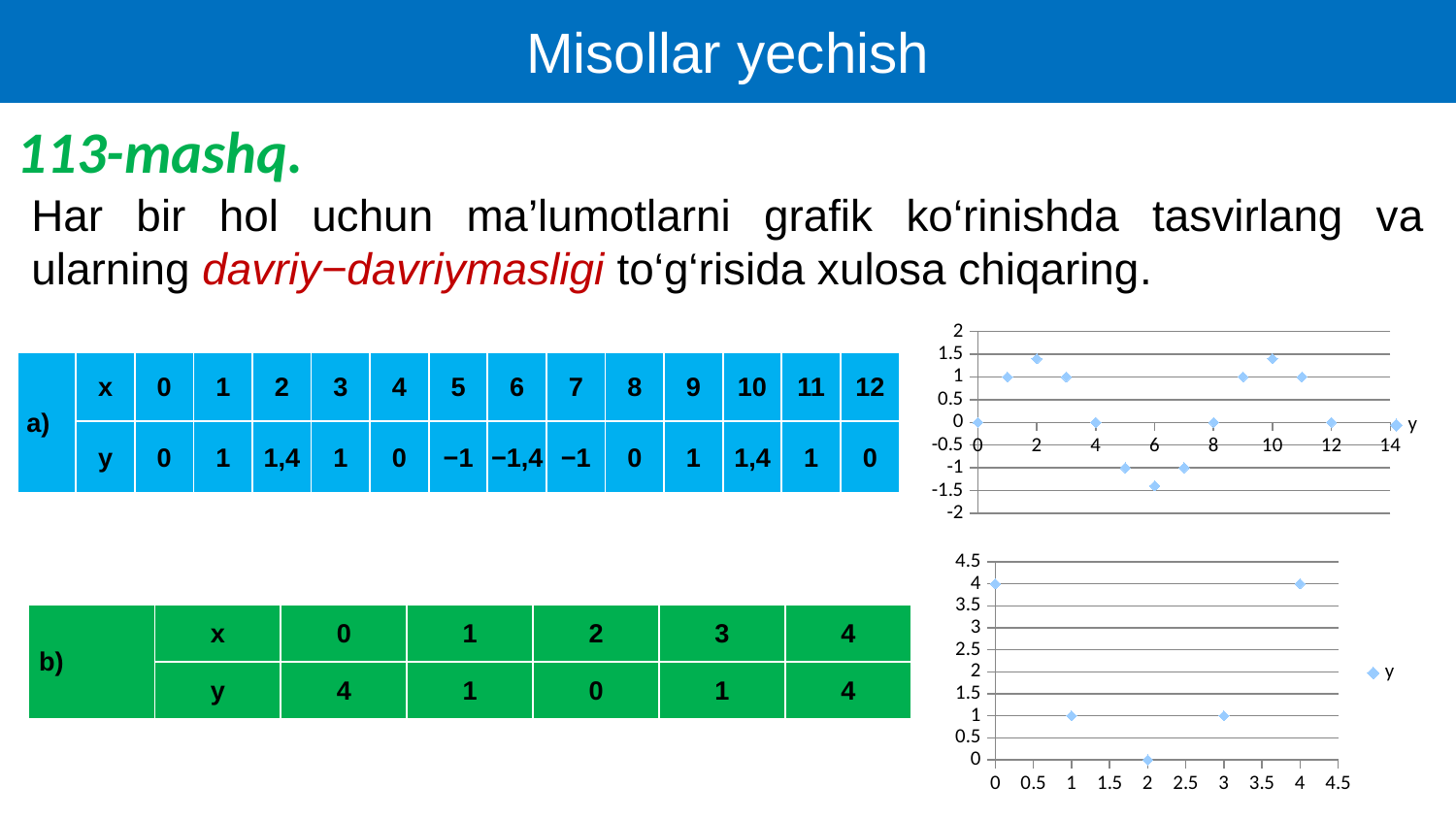
In the bottom chart, at which x value is the y value lowest? 2 In the bottom chart, do the y values rise or fall as x goes from 2 to 4? rise What kind of chart is the top chart on the right of the slide? scatter chart In the bottom chart, what is the y value at x = 0? 4 In the bottom chart, what is the difference between the y value at x = 0 and the y value at x = 1? 3 In the bottom chart, what is the y value at x = 2? 0 In the top chart, at which x value is the y value lowest? 6 How many series does the legend of the bottom chart list? 1 How many data points are plotted in the top chart on the right of the slide? 13 How many data points are plotted in the bottom chart on the right of the slide? 5 In the top chart, is the y value at x = 6 greater or less than -1? less In the bottom chart, which has the larger y value: x = 1 or x = 2? x = 1